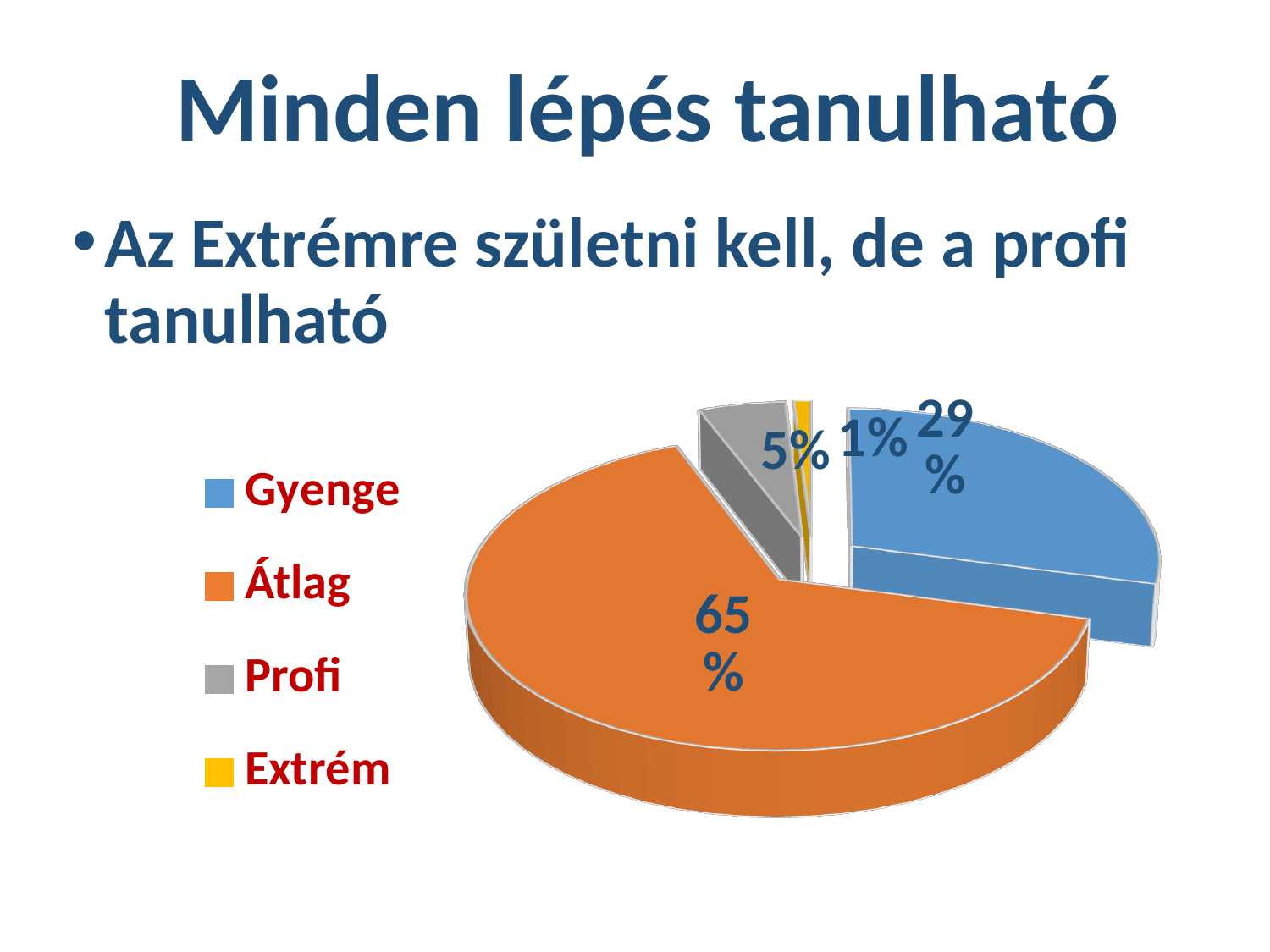
What is the value for Profi? 5% What kind of chart is shown on the slide? pie chart What is the value for Extrém? 1% What is the difference between the values for Profi and Extrém? 4% What is the difference between the values for Átlag and Gyenge? 36% What colour is the slice for Profi? grey Which is larger, the value for Gyenge or the value for Profi? Gyenge Which category has the smallest share of the pie? Extrém What is the value for Gyenge? 29% What is the value for Átlag? 65% Which category has the largest share of the pie? Átlag How many categories does the pie chart have? 4